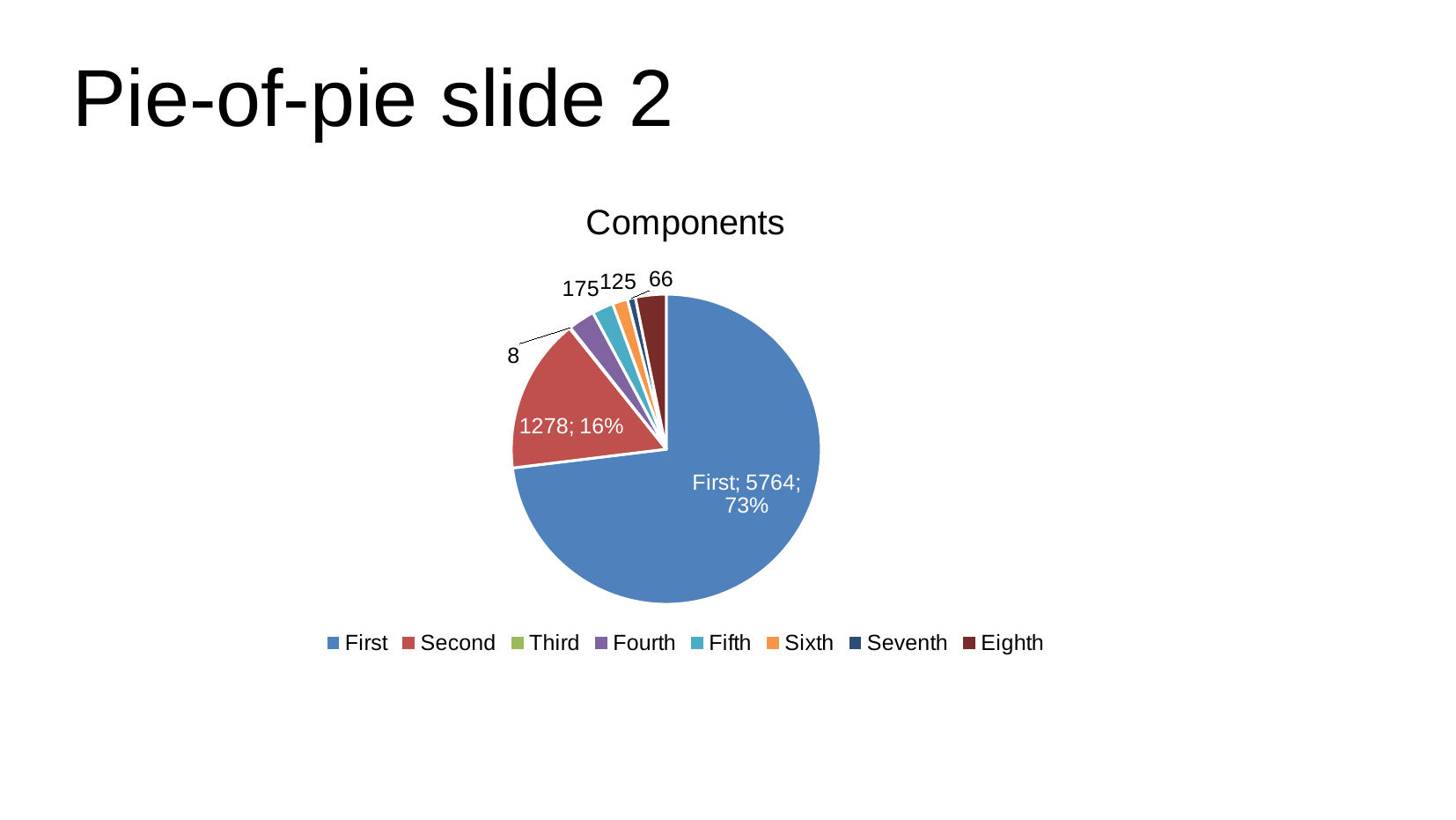
How many categories does the legend list? 8 Which is larger, First or Second? First What colour represents First in the legend? blue What is the value for Second? 1278 What kind of chart is shown on the slide? pie chart Which category has the largest slice? First What share of the pie does Second represent? 16% What is the difference between the values for First and Second? 4486 What is the title of the chart? Components What is the value for First? 5764 What share of the pie does First represent? 73%